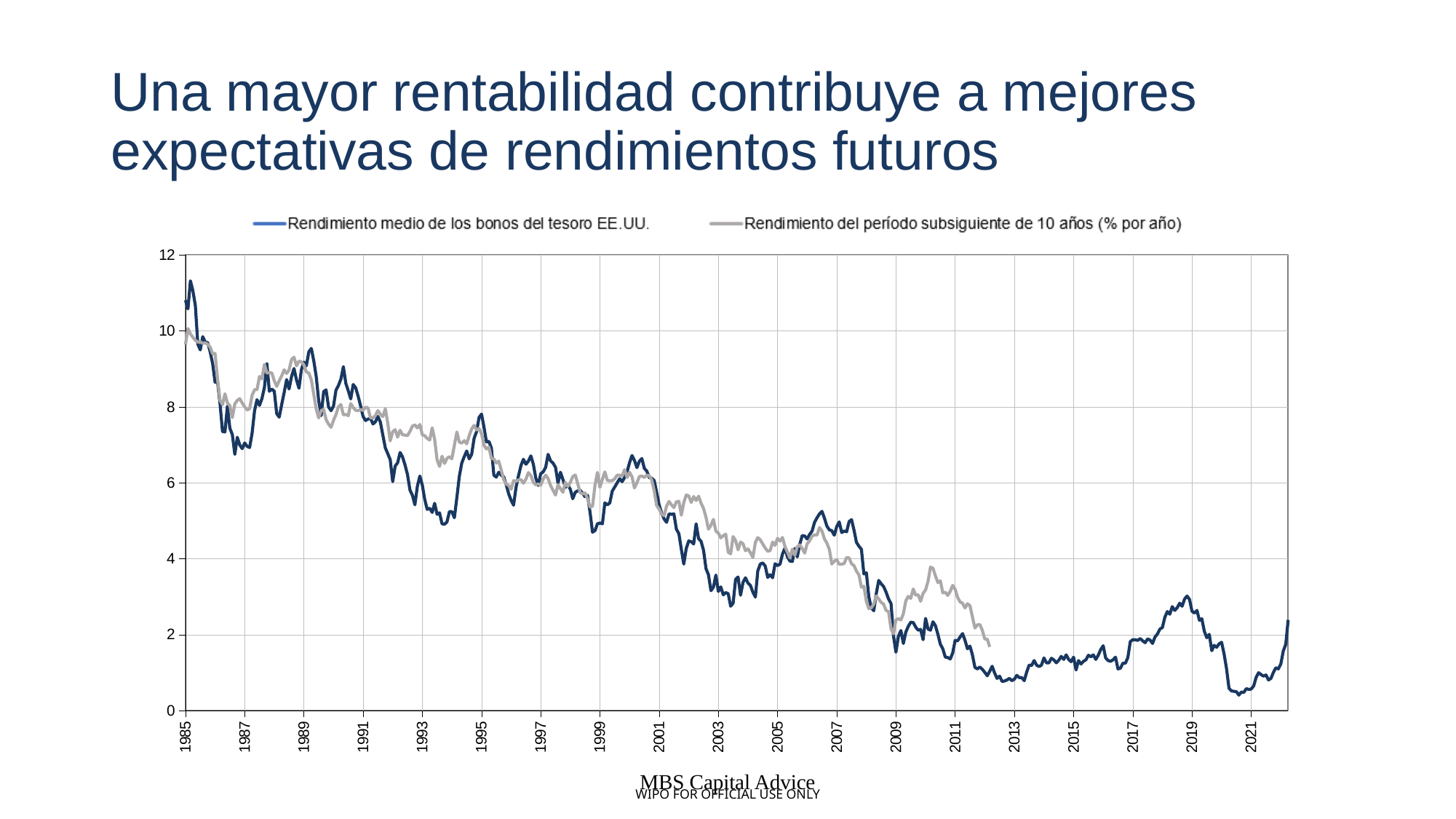
What kind of chart is shown on the slide? line chart Is the value of 'Rendimiento medio de los bonos del tesoro EE.UU.' at the start of 1985 greater or less than 10? greater Around 1993, which series is higher: 'Rendimiento medio de los bonos del tesoro EE.UU.' or 'Rendimiento del período subsiguiente de 10 años (% por año)'? Rendimiento del período subsiguiente de 10 años (% por año) What are the two series named in the legend? Rendimiento medio de los bonos del tesoro EE.UU.; Rendimiento del período subsiguiente de 10 años (% por año) How many series does the legend list? 2 What colour is the line for 'Rendimiento medio de los bonos del tesoro EE.UU.'? dark blue Is the peak of 'Rendimiento medio de los bonos del tesoro EE.UU.' around 2019 greater or less than 4? less Is the value of 'Rendimiento medio de los bonos del tesoro EE.UU.' around 2020 greater or less than 2? less What is the highest value shown on the vertical axis? 12 Overall, does the 'Rendimiento medio de los bonos del tesoro EE.UU.' series rise or fall from 1985 to 2021? fall Around 2003, which series is higher: 'Rendimiento medio de los bonos del tesoro EE.UU.' or 'Rendimiento del período subsiguiente de 10 años (% por año)'? Rendimiento del período subsiguiente de 10 años (% por año)